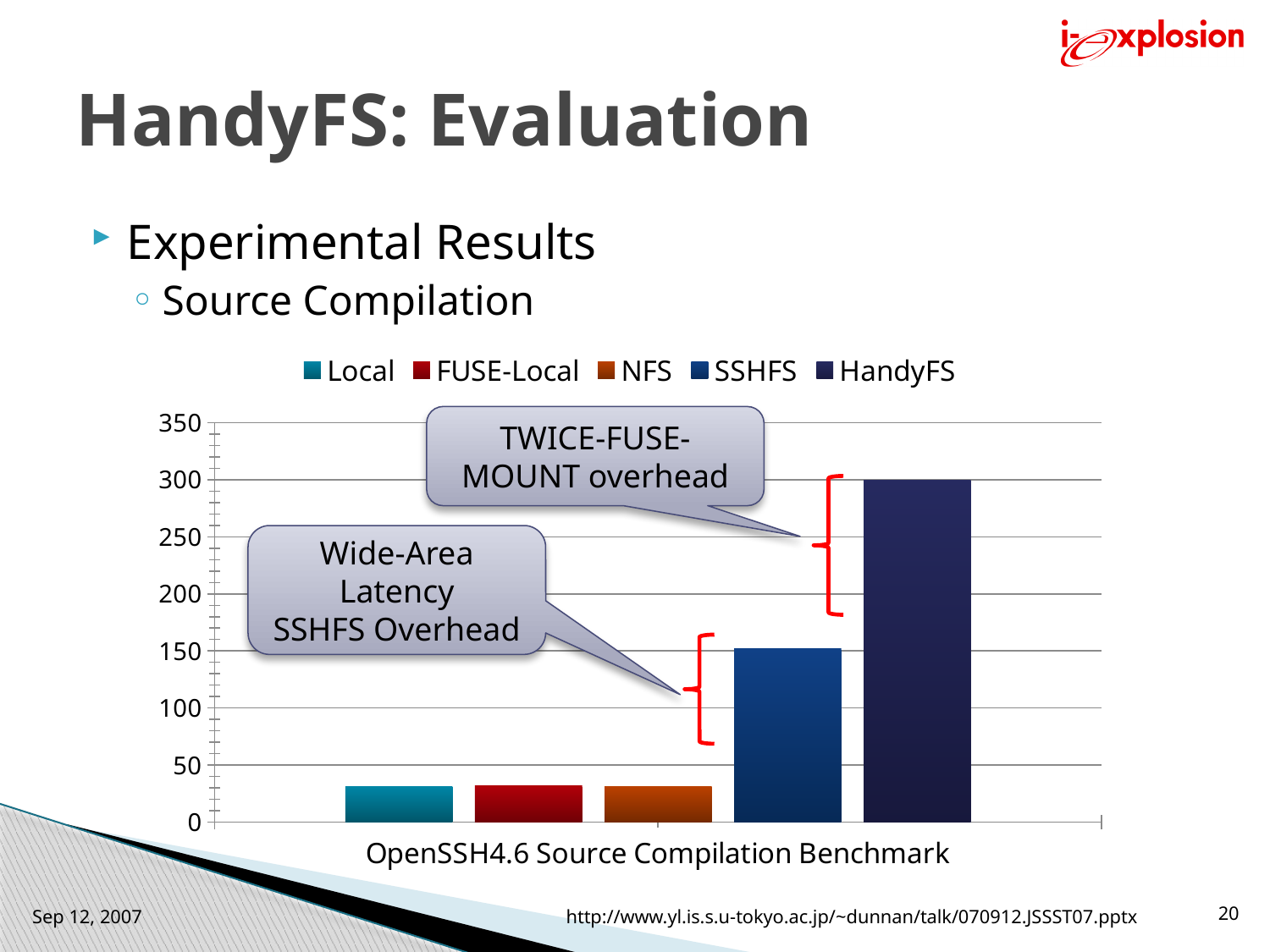
Which is larger, the value for FUSE-Local or the value for SSHFS? SSHFS What is the highest value shown on the chart's y axis? 350 How many series does the chart legend list? 5 Which is larger, the value for SSHFS or the value for HandyFS? HandyFS Is the value for NFS greater or less than 50? less What is the category label shown on the x axis of the chart? OpenSSH4.6 Source Compilation Benchmark What kind of chart is shown on the slide? bar chart Is the value for HandyFS greater or less than 250? greater Which series has the highest bar in the chart? HandyFS Is the value for SSHFS greater or less than 200? less